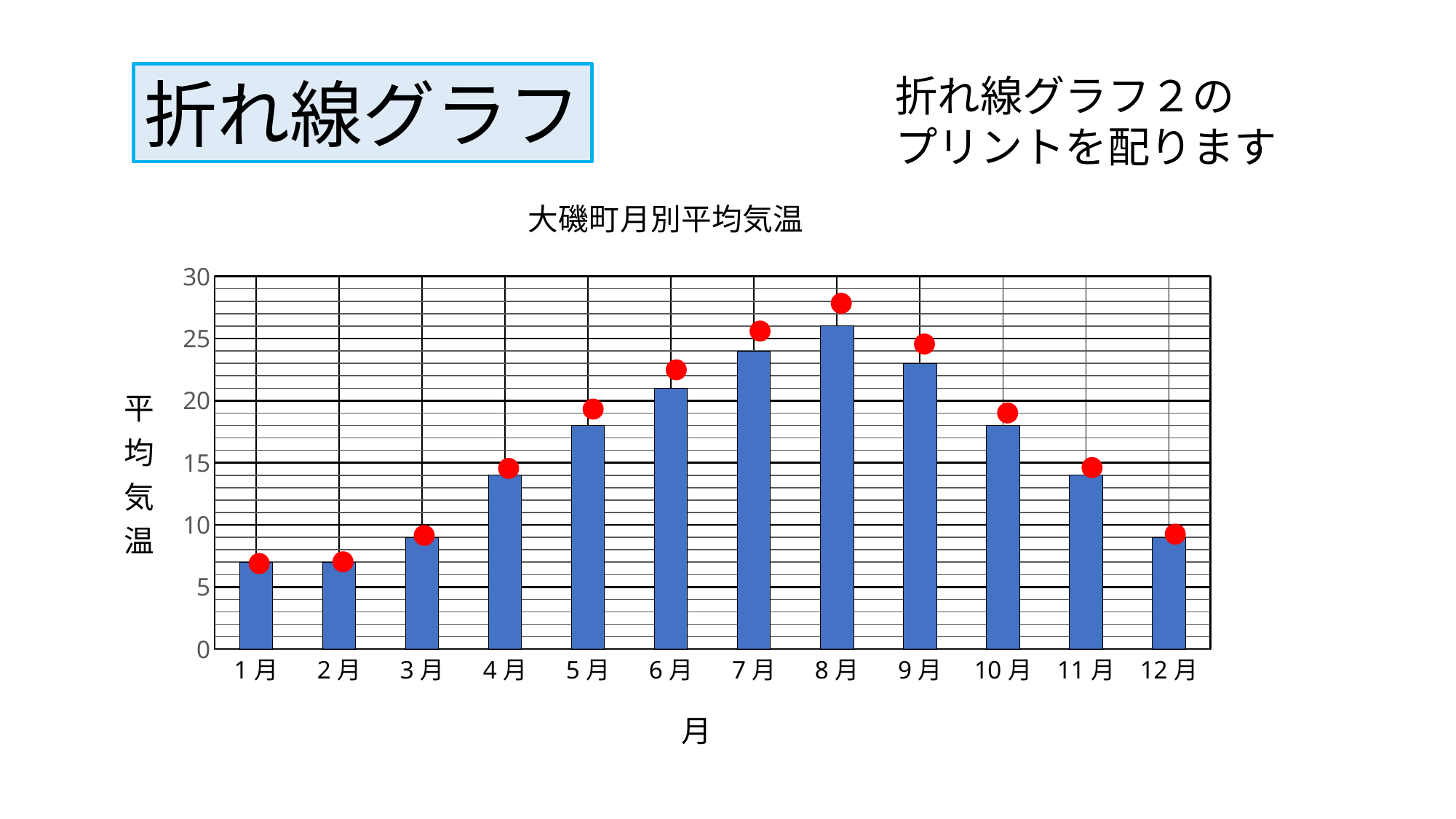
How many months are plotted on the x axis of the chart? 12 Is the value for 8月 greater or less than 25? greater Is the value for 6月 greater or less than 20? greater What kind of chart is shown on the slide? bar chart Which is larger, the value for 4月 or the value for 10月? 10月 What is the title of the chart? 大磯町月別平均気温 Is the value for 5月 greater or less than 20? less Which is larger, the value for 5月 or the value for 11月? 5月 Do the values rise or fall from 1月 to 8月? rise Which month has the highest average temperature in the chart? 8月